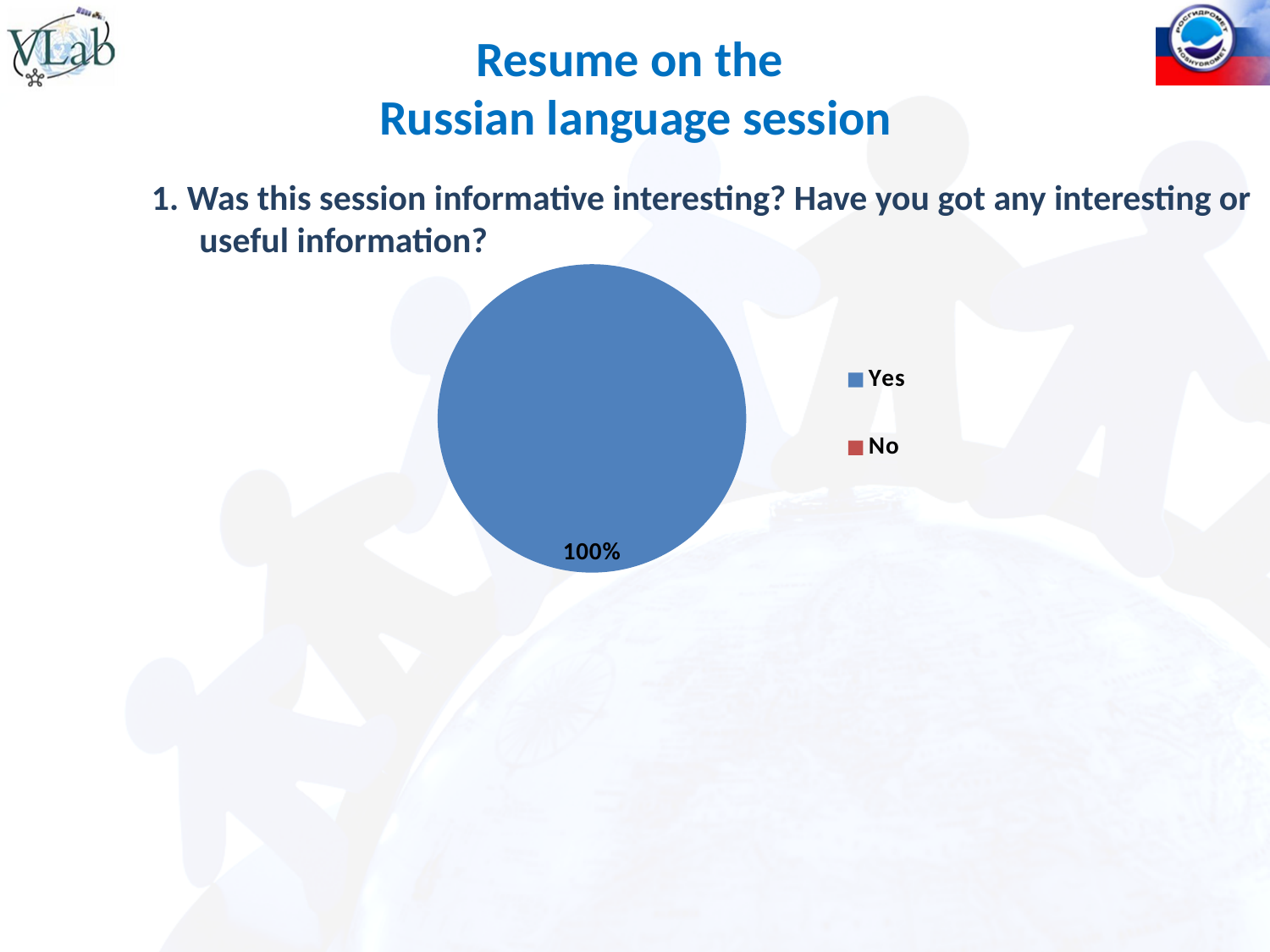
What colour does the legend use for No? red Which is larger, the share for Yes or the share for No? Yes Which category has the largest share of the pie? Yes What is the only percentage label printed on the pie chart? 100% What share of the pie does the Yes slice take? 100% How many entries does the legend list? 2 What kind of chart is shown on the slide? pie chart What colour is the Yes slice in the pie chart? blue Which category has the smallest share of the pie? No